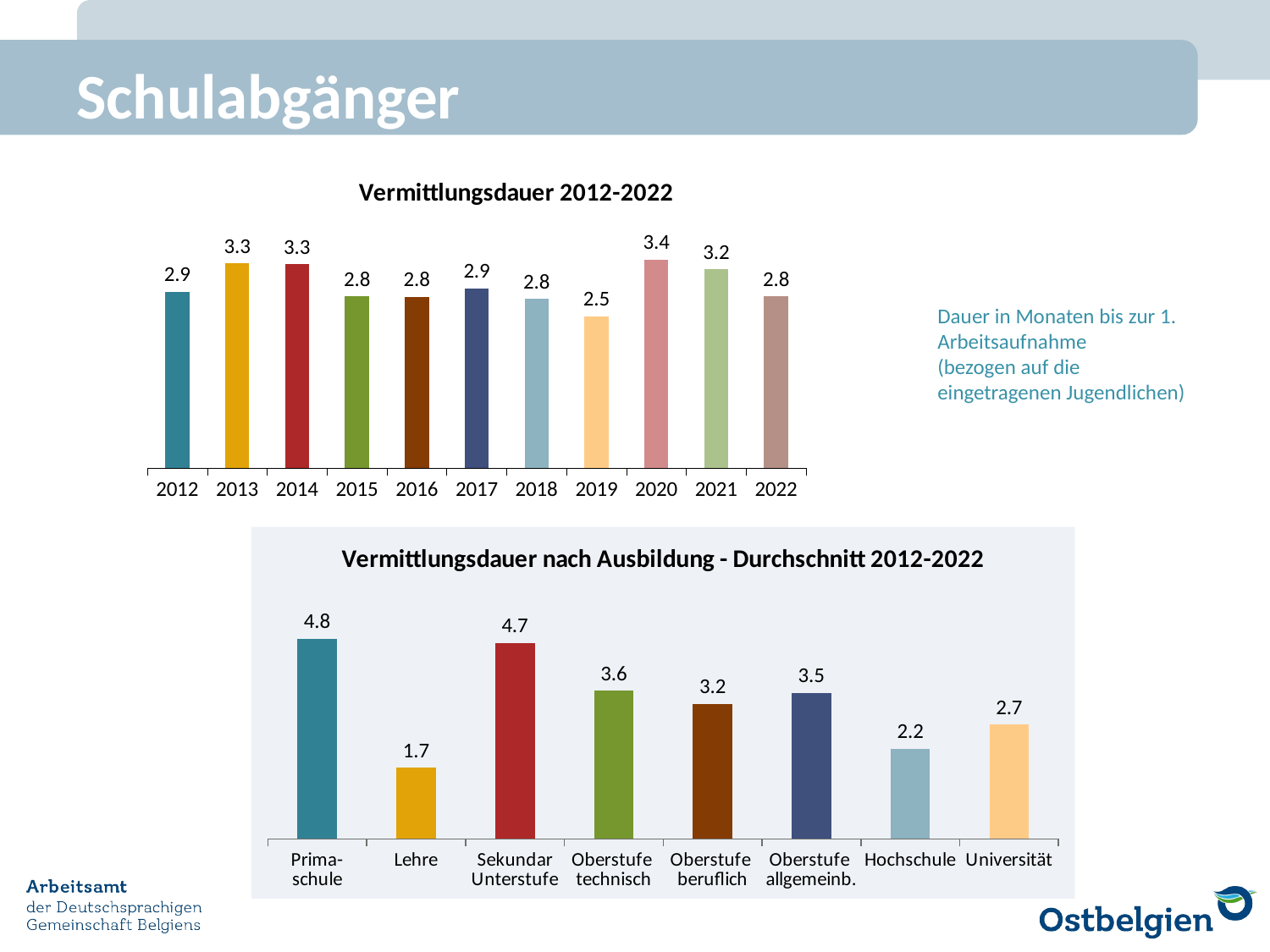
In the 'Vermittlungsdauer 2012-2022' chart, how many years are shown? 11 In the 'Vermittlungsdauer 2012-2022' chart, what is the difference between the values for 2020 and 2019? 0.9 In the 'Vermittlungsdauer 2012-2022' chart, which year has the lowest value? 2019 What type of chart is the 'Vermittlungsdauer nach Ausbildung - Durchschnitt 2012-2022' chart? bar chart In the 'Vermittlungsdauer nach Ausbildung - Durchschnitt 2012-2022' chart, how many categories are shown? 8 In the 'Vermittlungsdauer nach Ausbildung - Durchschnitt 2012-2022' chart, which category has the lowest value? Lehre In the 'Vermittlungsdauer nach Ausbildung - Durchschnitt 2012-2022' chart, what is the value for Lehre? 1.7 In the 'Vermittlungsdauer 2012-2022' chart, is the value for 2013 larger or smaller than the value for 2015? larger In the 'Vermittlungsdauer 2012-2022' chart, what is the value for 2020? 3.4 In the 'Vermittlungsdauer 2012-2022' chart, which year has the highest value? 2020 In the 'Vermittlungsdauer nach Ausbildung - Durchschnitt 2012-2022' chart, what is the difference between the values for Primaschule and Universität? 2.1 In the 'Vermittlungsdauer nach Ausbildung - Durchschnitt 2012-2022' chart, which category has the highest value? Primaschule